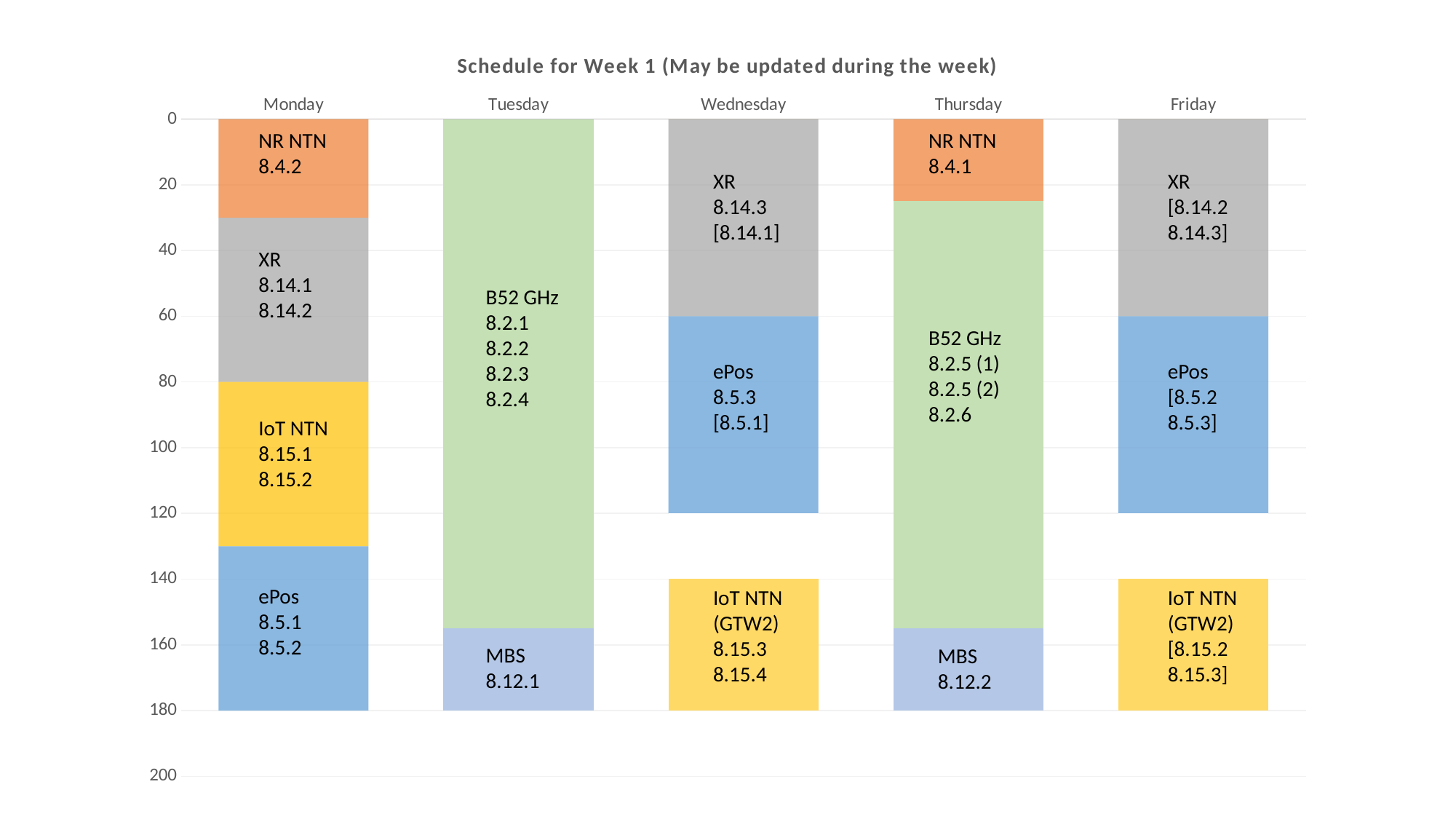
How many days (categories) are shown along the x axis of the chart? 5 Which session occupies the smallest portion of the Monday bar? NR NTN What is the title of the chart? Schedule for Week 1 (May be updated during the week) On Monday, which segment is larger: XR or NR NTN? XR Which agenda items are listed under B52 GHz on Thursday? 8.2.5 (1), 8.2.5 (2), 8.2.6 Which agenda items are listed under IoT NTN on Monday? 8.15.1, 8.15.2 On Wednesday, is the boundary between the XR and ePos segments at a value greater or less than 80? less On which days does the chart show an NR NTN session? Monday and Thursday On which day is the MBS 8.12.1 session scheduled? Tuesday Which colour is used for the ePos segments in the chart? Blue Which session occupies the largest portion of the Thursday bar? B52 GHz What kind of chart is shown on the slide? Stacked bar chart